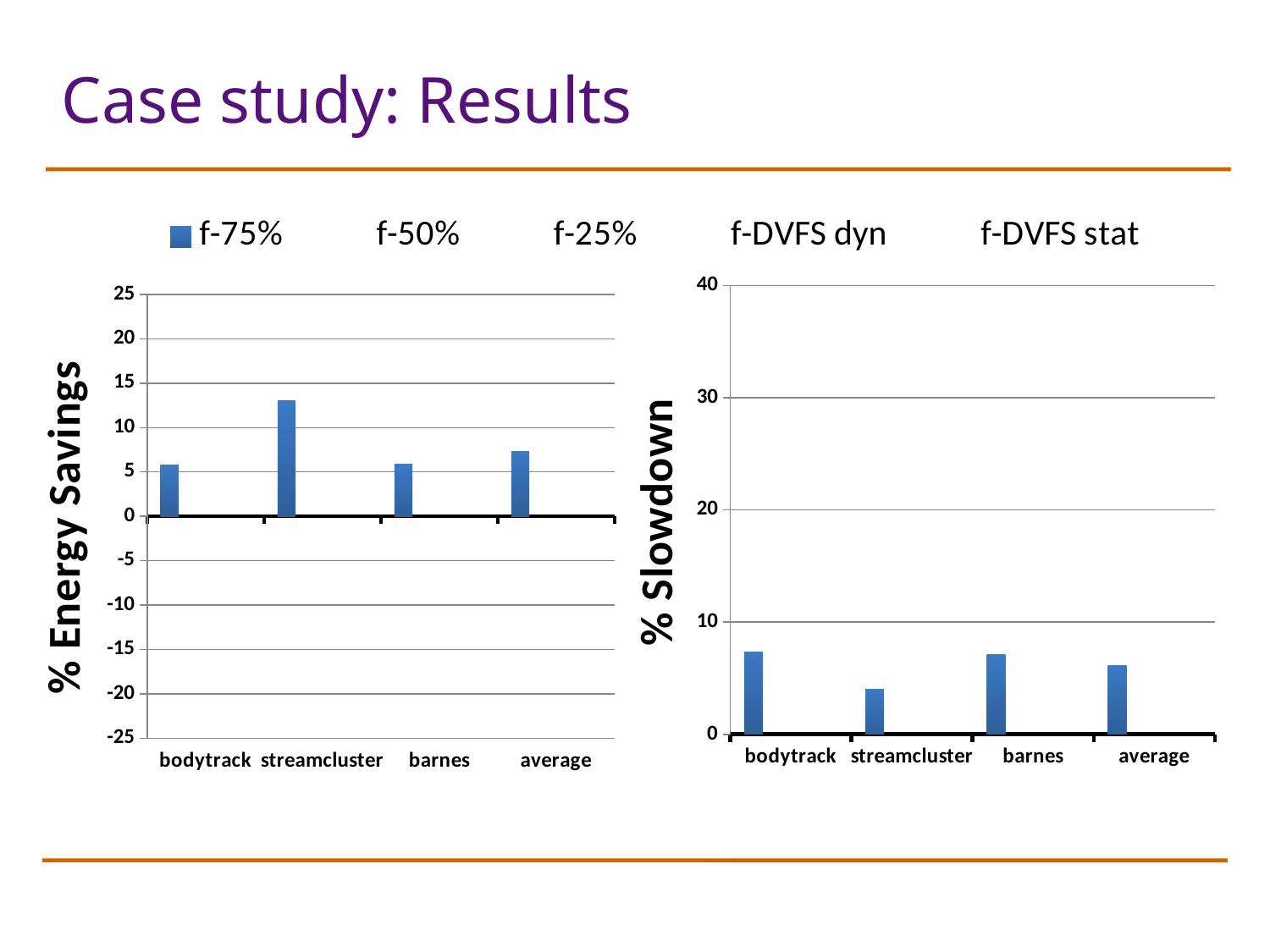
In the % Energy Savings chart on the left, is the value for streamcluster greater or less than 15? less In the % Slowdown chart on the right, is the value for bodytrack greater or less than 10? less In the % Energy Savings chart on the left, is the value for streamcluster greater or less than 10? greater What is the y-axis label of the chart on the right? % Slowdown How many categories are shown on the x axis of the % Slowdown chart on the right? 4 In the % Energy Savings chart on the left, which category has the highest value? streamcluster In the % Energy Savings chart on the left, which is larger, the value for streamcluster or the value for average? streamcluster In the % Slowdown chart on the right, which is larger, the value for bodytrack or the value for streamcluster? bodytrack In the % Slowdown chart on the right, which category has the lowest value? streamcluster How many series does the legend at the top of the slide list? 5 What kind of chart is the % Energy Savings chart on the left? bar chart